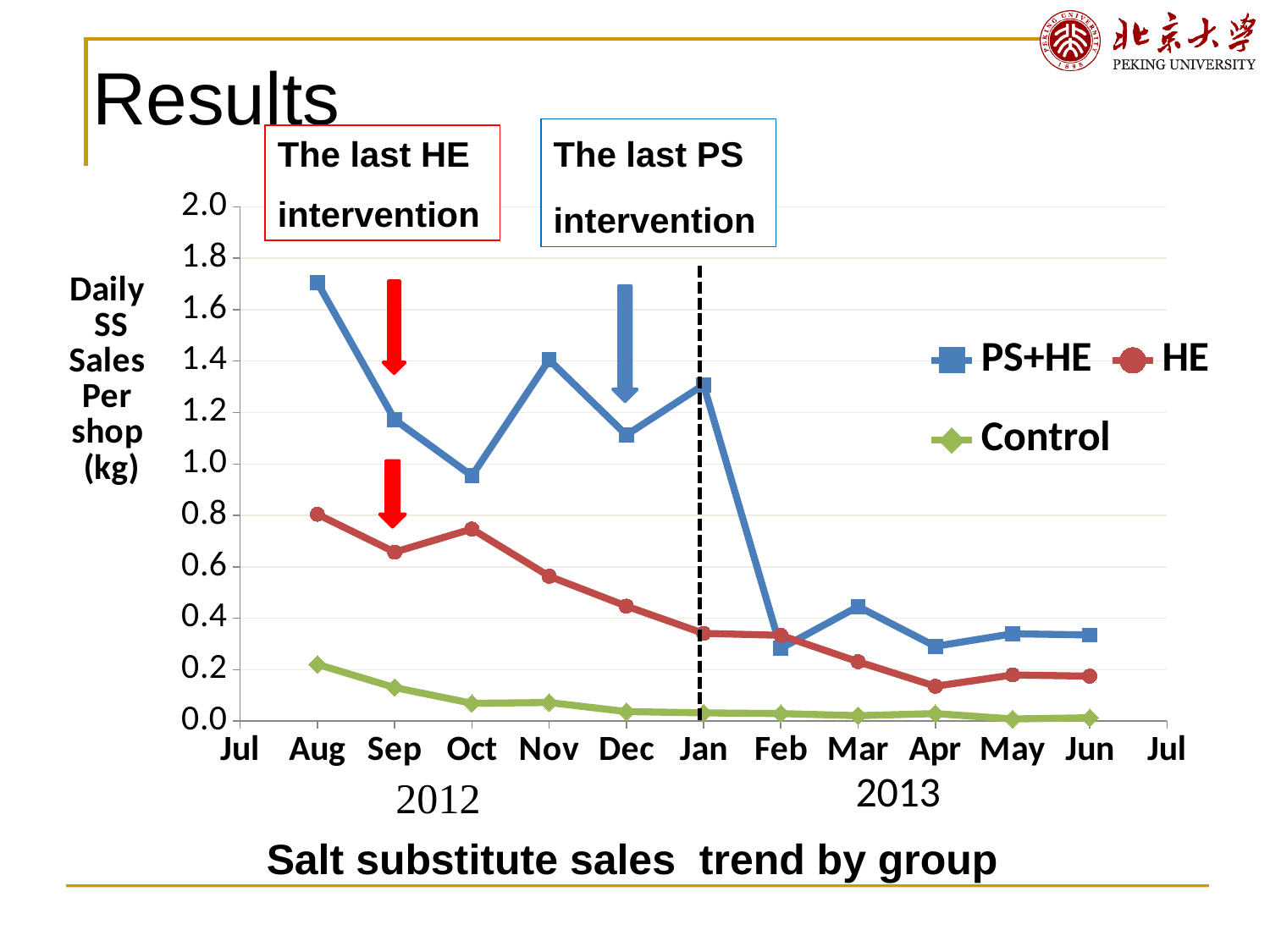
In which month does the PS+HE series reach its highest value? Aug Which series has the larger value in Jan, PS+HE or HE? PS+HE Which series are listed in the legend? PS+HE, HE, Control Does the Control series generally rise or fall from Aug to Jun? fall How many series does the legend list? 3 Which series has the larger value in Jun, HE or Control? HE What kind of chart is shown on the slide? line chart Is the PS+HE value for Aug greater or less than 1.6? greater Is the HE value for Sep greater or less than 0.6? greater What is the caption/title of the chart? Salt substitute sales trend by group Is the PS+HE value for Feb greater or less than 0.4? less How many monthly data points are plotted for the PS+HE series? 11